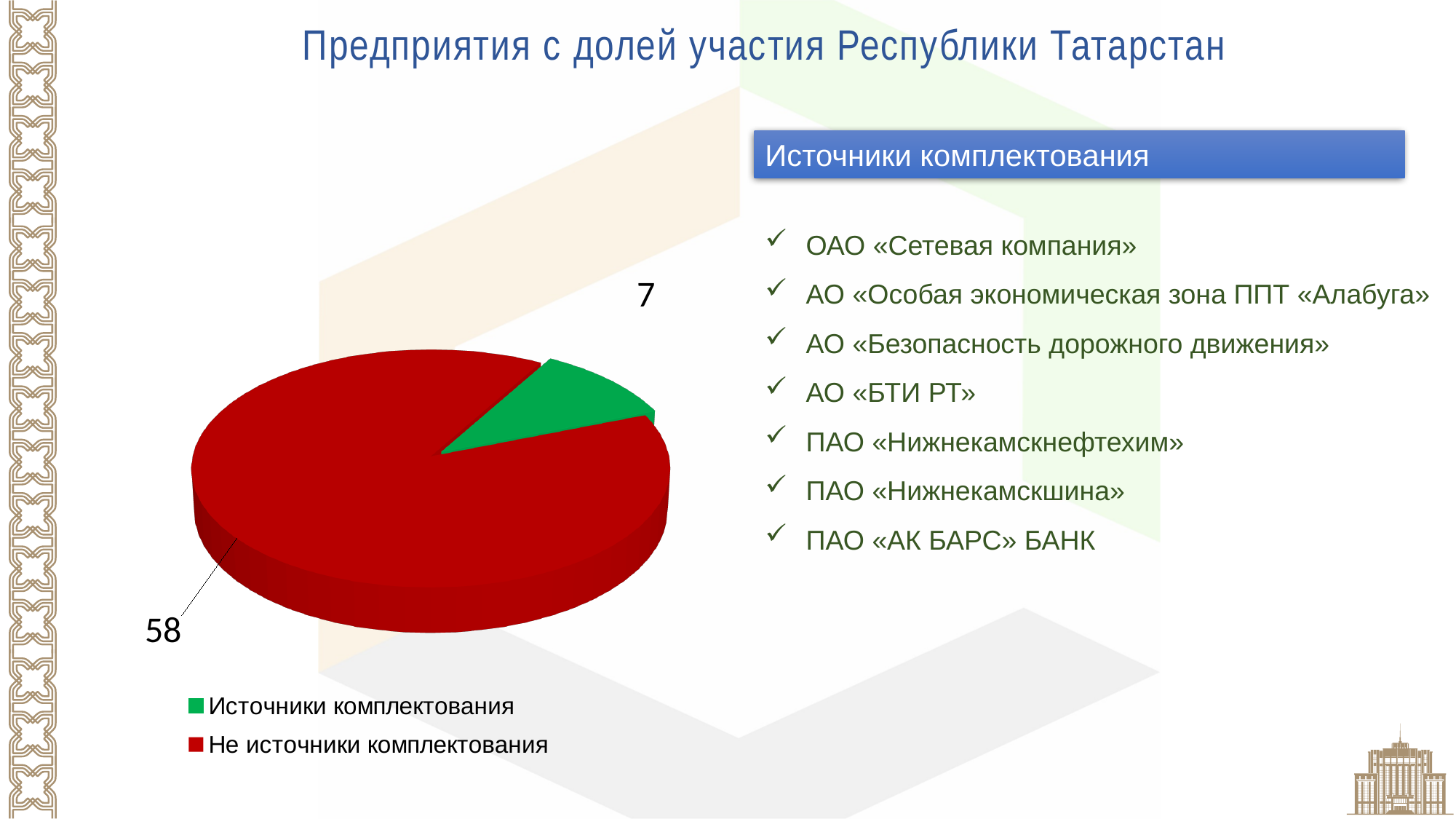
Which slice of the pie chart is the smallest? Источники комплектования What is the value for «Не источники комплектования» in the pie chart? 58 How many entries does the legend of the pie chart list? 2 What type of chart is shown on the slide? pie chart What is the value for «Источники комплектования» in the pie chart? 7 What is the difference between the values for «Не источники комплектования» and «Источники комплектования»? 51 Which is larger: «Источники комплектования» or «Не источники комплектования»? Не источники комплектования Which slice of the pie chart is the largest? Не источники комплектования What colour is the «Не источники комплектования» slice in the pie chart? red How many slices does the pie chart have? 2 What colour is the «Источники комплектования» slice in the pie chart? green What is the total of the two values shown in the pie chart? 65